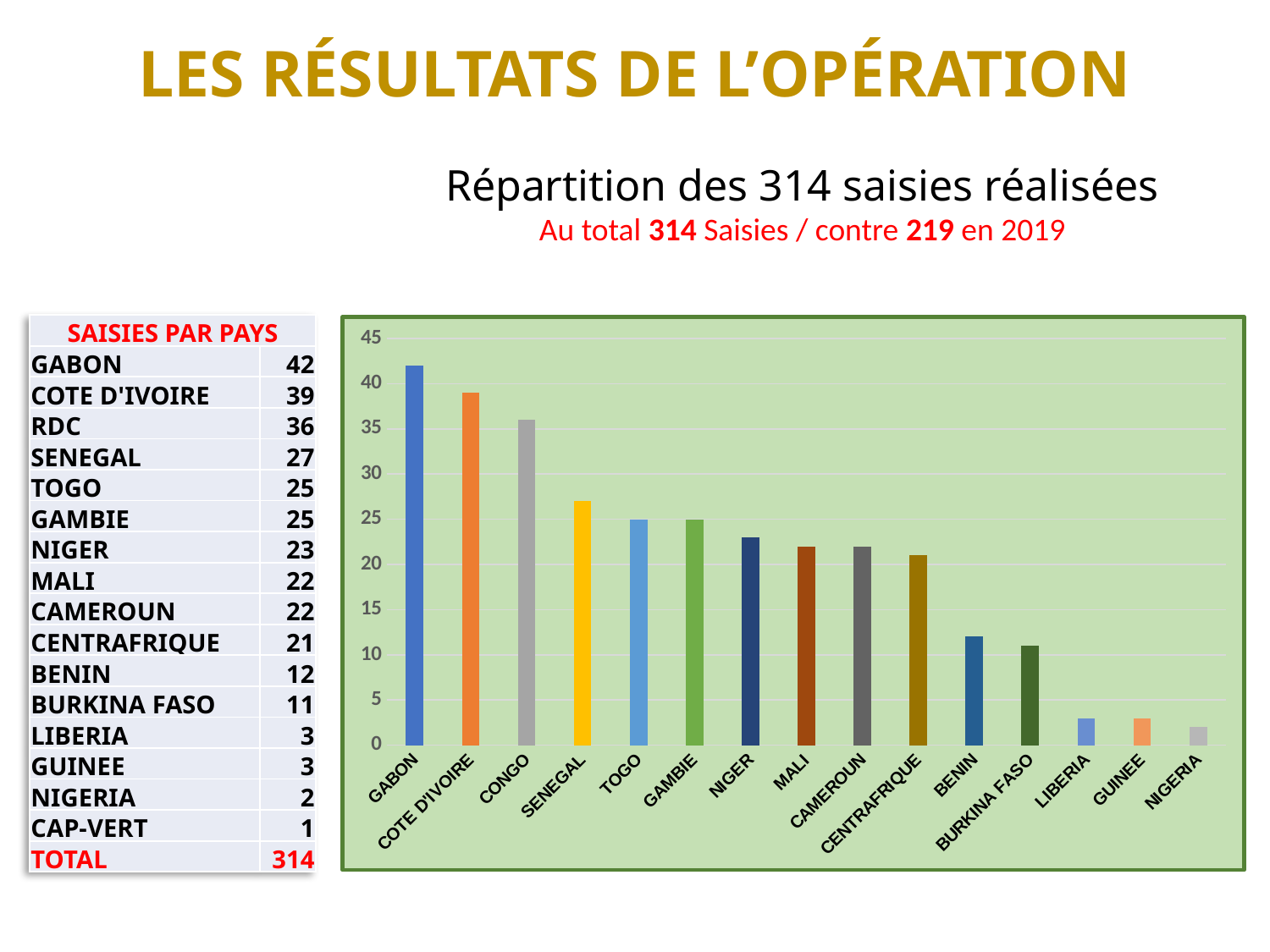
Do the bar values rise or fall from left to right along the x axis? fall Which country has the highest bar in the chart? GABON Is the value for COTE D'IVOIRE greater or less than 35? greater What is the title given above the chart? Répartition des 314 saisies réalisées What is the value for TOGO in the chart? 25 Which is larger, the value for SENEGAL or the value for NIGER? SENEGAL Which country has the lowest bar in the chart? NIGERIA What is the difference between the values for GABON and COTE D'IVOIRE? 3 How many countries are plotted as bars in the chart? 15 Is the value for CENTRAFRIQUE greater or less than 25? less What is the value for GABON in the chart? 42 What kind of chart is shown on the slide? bar chart